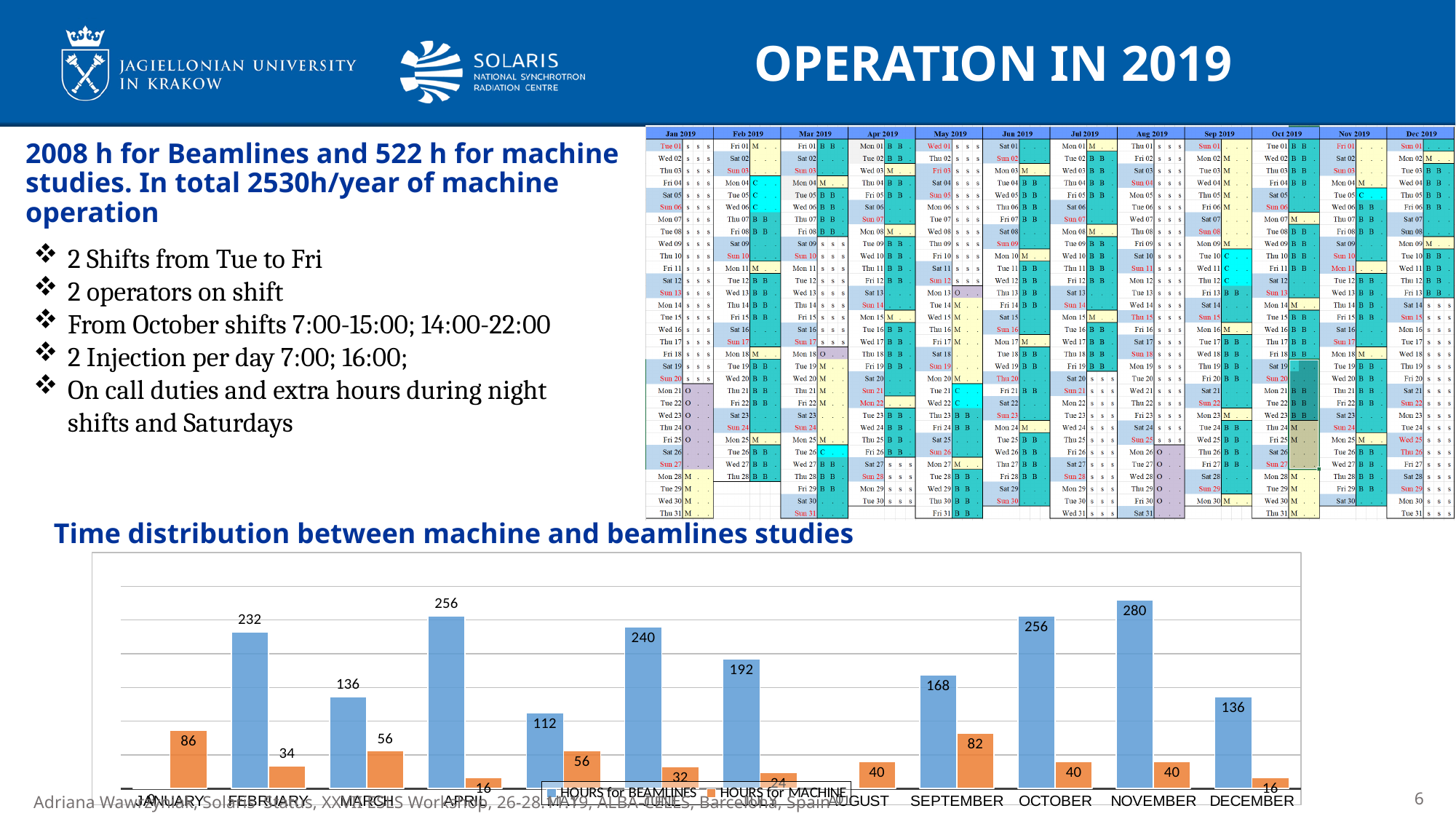
How many series does the legend of the chart 'Time distribution between machine and beamlines studies' list? 2 How many months are shown on the x axis of the chart 'Time distribution between machine and beamlines studies'? 12 In the chart 'Time distribution between machine and beamlines studies', how many HOURS for MACHINE are shown for SEPTEMBER? 82 In the chart 'Time distribution between machine and beamlines studies', how much higher are the HOURS for BEAMLINES in NOVEMBER than in FEBRUARY? 48 In the chart 'Time distribution between machine and beamlines studies', which is larger in MARCH, HOURS for BEAMLINES or HOURS for MACHINE? HOURS for BEAMLINES In the chart 'Time distribution between machine and beamlines studies', how many HOURS for MACHINE are shown for DECEMBER? 16 In the chart 'Time distribution between machine and beamlines studies', which month has the highest HOURS for BEAMLINES? NOVEMBER In the chart 'Time distribution between machine and beamlines studies', how many HOURS for BEAMLINES are shown for NOVEMBER? 280 In the chart 'Time distribution between machine and beamlines studies', which month has more HOURS for BEAMLINES, FEBRUARY or APRIL? APRIL In the chart 'Time distribution between machine and beamlines studies', which month has the highest HOURS for MACHINE? JANUARY In the chart 'Time distribution between machine and beamlines studies', what is the difference between HOURS for BEAMLINES and HOURS for MACHINE in OCTOBER? 216 What kind of chart is 'Time distribution between machine and beamlines studies'? Bar chart